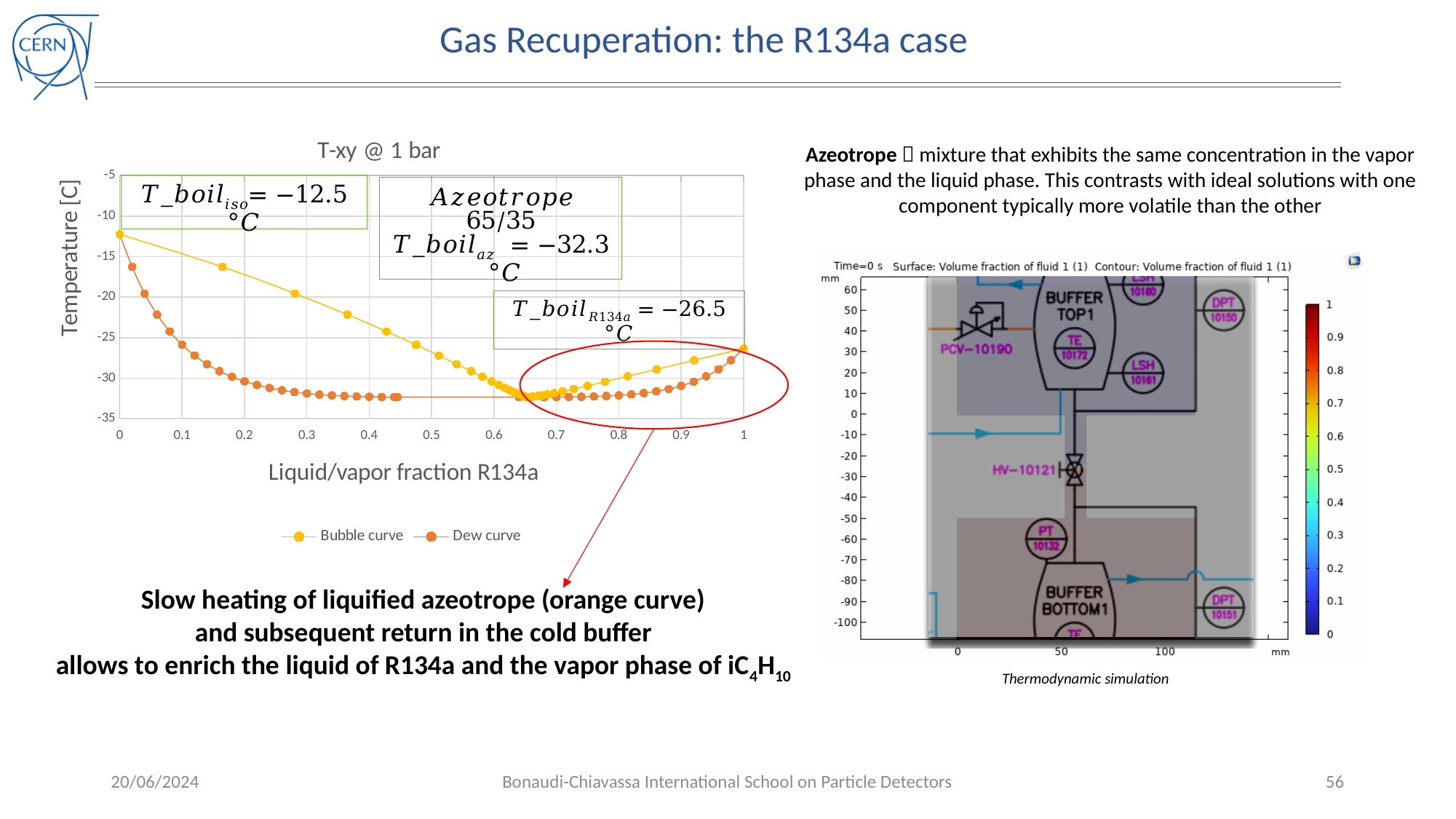
In the T-xy @ 1 bar chart, does the Dew curve rise or fall as the fraction increases from 0.8 to 1? rise What is the title of the chart on the left of the slide? T-xy @ 1 bar In the T-xy @ 1 bar chart, is the Bubble curve value at a fraction of 0.5 greater or less than -25? less What kind of chart is the T-xy @ 1 bar chart? line chart In the T-xy @ 1 bar chart, is the Dew curve value at a fraction of 0.3 greater or less than -30? less In the T-xy @ 1 bar chart, is the Bubble curve value at a fraction of 0.3 greater or less than -25? greater In the T-xy @ 1 bar chart, which series has the higher temperature at a fraction of 0.3, the Bubble curve or the Dew curve? Bubble curve How many series does the legend of the T-xy @ 1 bar chart list? 2 In the T-xy @ 1 bar chart, which series has the higher temperature at a fraction of 0.9, the Bubble curve or the Dew curve? Bubble curve In the T-xy @ 1 bar chart, does the Bubble curve rise or fall as the fraction increases from 0 to 0.5? fall What is the label of the x axis of the T-xy @ 1 bar chart? Liquid/vapor fraction R134a